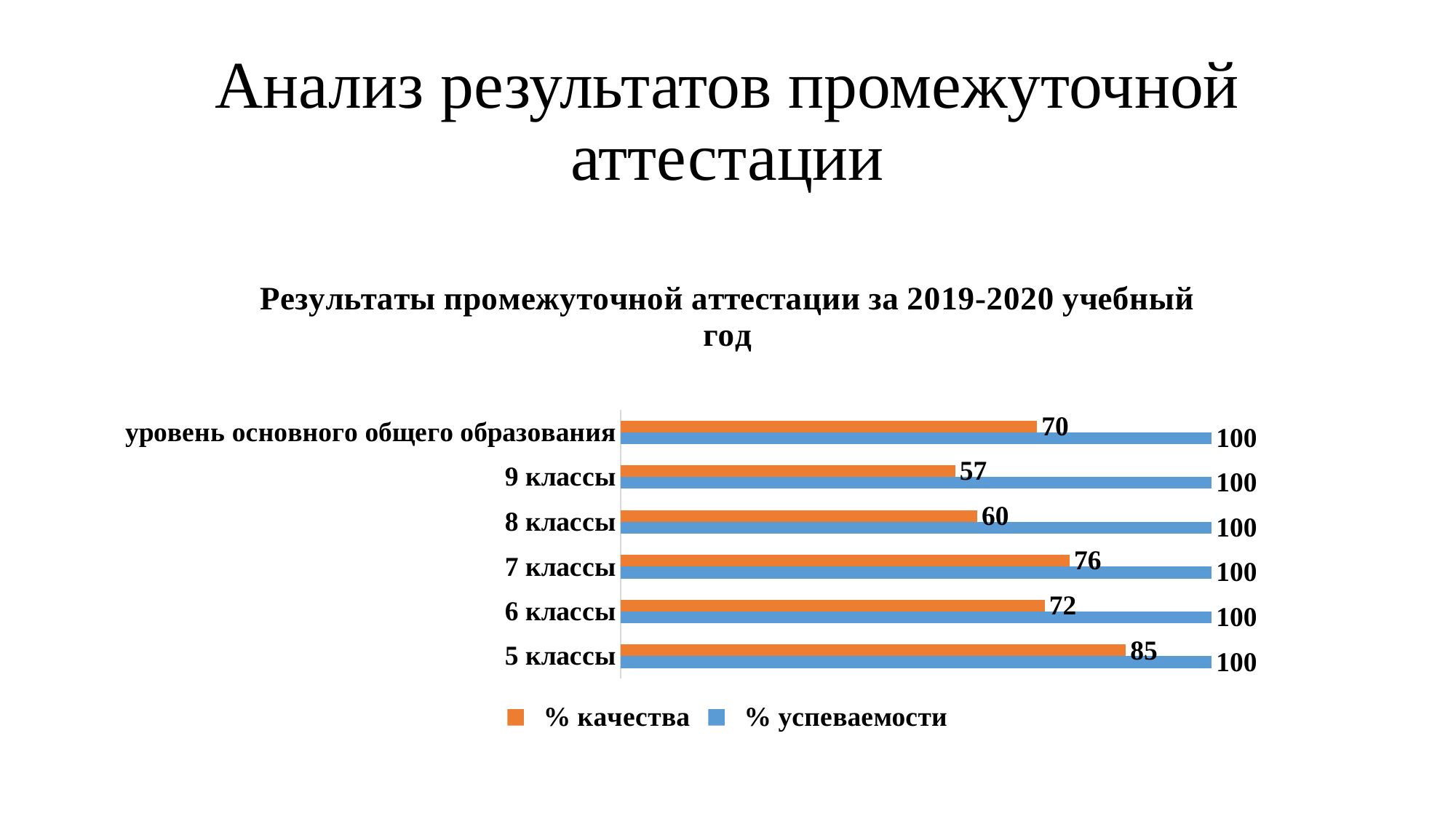
What is the % успеваемости value for 7 классы? 100 Which has a higher % качества, 7 классы or 6 классы? 7 классы How many series does the legend list? 2 How many categories are shown on the chart? 6 Which category has the lowest % качества? 9 классы What is the % качества value for 5 классы? 85 Which category has the highest % качества? 5 классы What kind of chart is shown on the slide? bar chart What is the % качества value for 9 классы? 57 What is the % качества value for уровень основного общего образования? 70 What is the title of the chart? Результаты промежуточной аттестации за 2019-2020 учебный год What is the difference between the % качества for 5 классы and 9 классы? 28